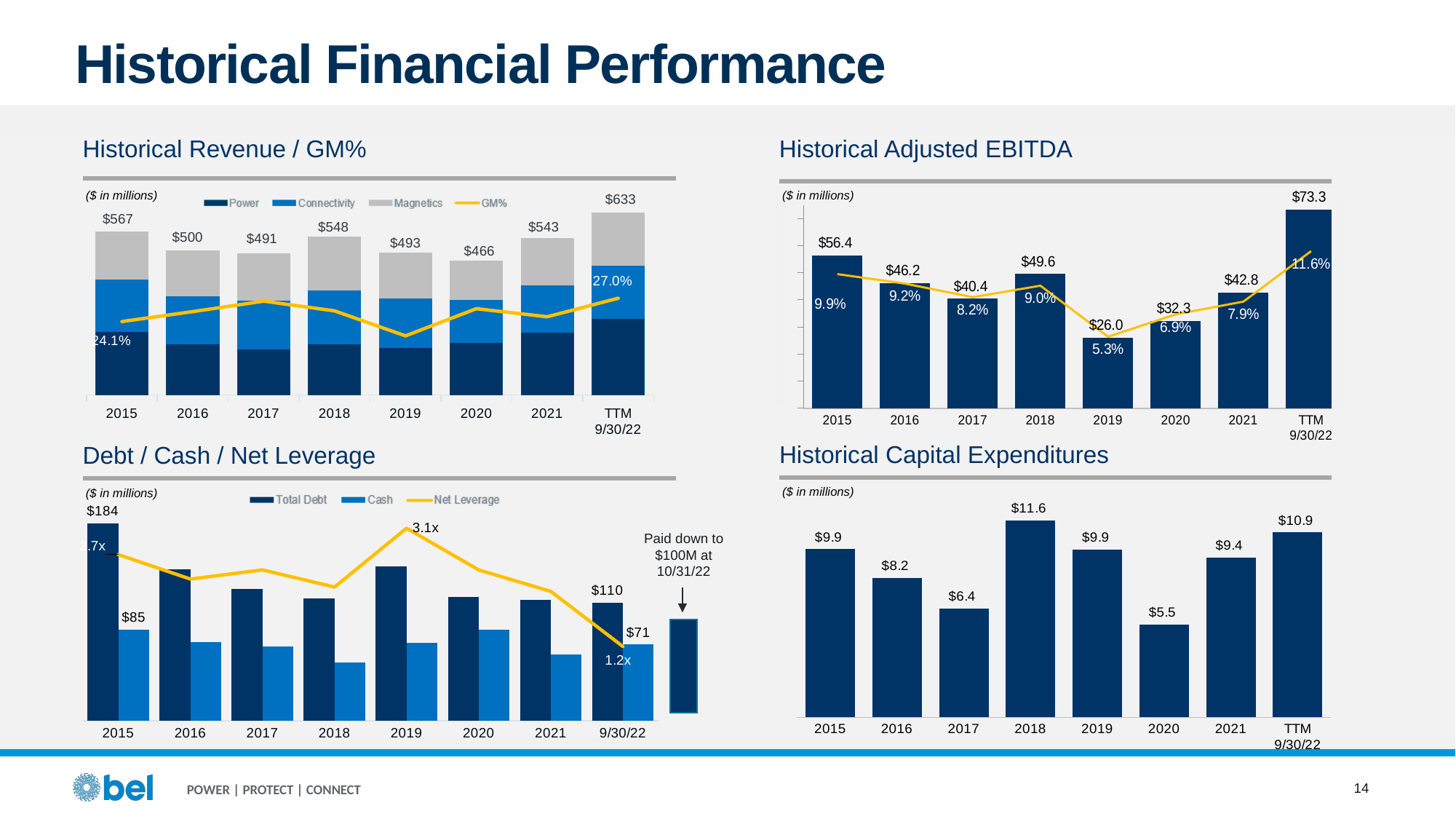
How many series does the legend of the Historical Revenue / GM% chart list? 4 In the Historical Adjusted EBITDA chart, which period has the highest adjusted EBITDA? TTM 9/30/22 In the Historical Revenue / GM% chart, what is the total revenue for 2020? $466 In the Historical Capital Expenditures chart, which year has the highest capital expenditures? 2018 In the Historical Capital Expenditures chart, which is larger, the value for 2016 or the value for 2021? 2021 In the Historical Capital Expenditures chart, what is the value for 2020? $5.5 In the Historical Adjusted EBITDA chart, which year has the lowest adjusted EBITDA? 2019 In the Debt / Cash / Net Leverage chart, what is the net leverage for 2019? 3.1x In the Historical Revenue / GM% chart, what is the GM% for TTM 9/30/22? 27.0% What kind of chart is the Historical Capital Expenditures chart? bar chart In the Historical Adjusted EBITDA chart, what is the adjusted EBITDA for 2019? $26.0 In the Historical Adjusted EBITDA chart, what is the difference between the TTM 9/30/22 value and the 2021 value? $30.5